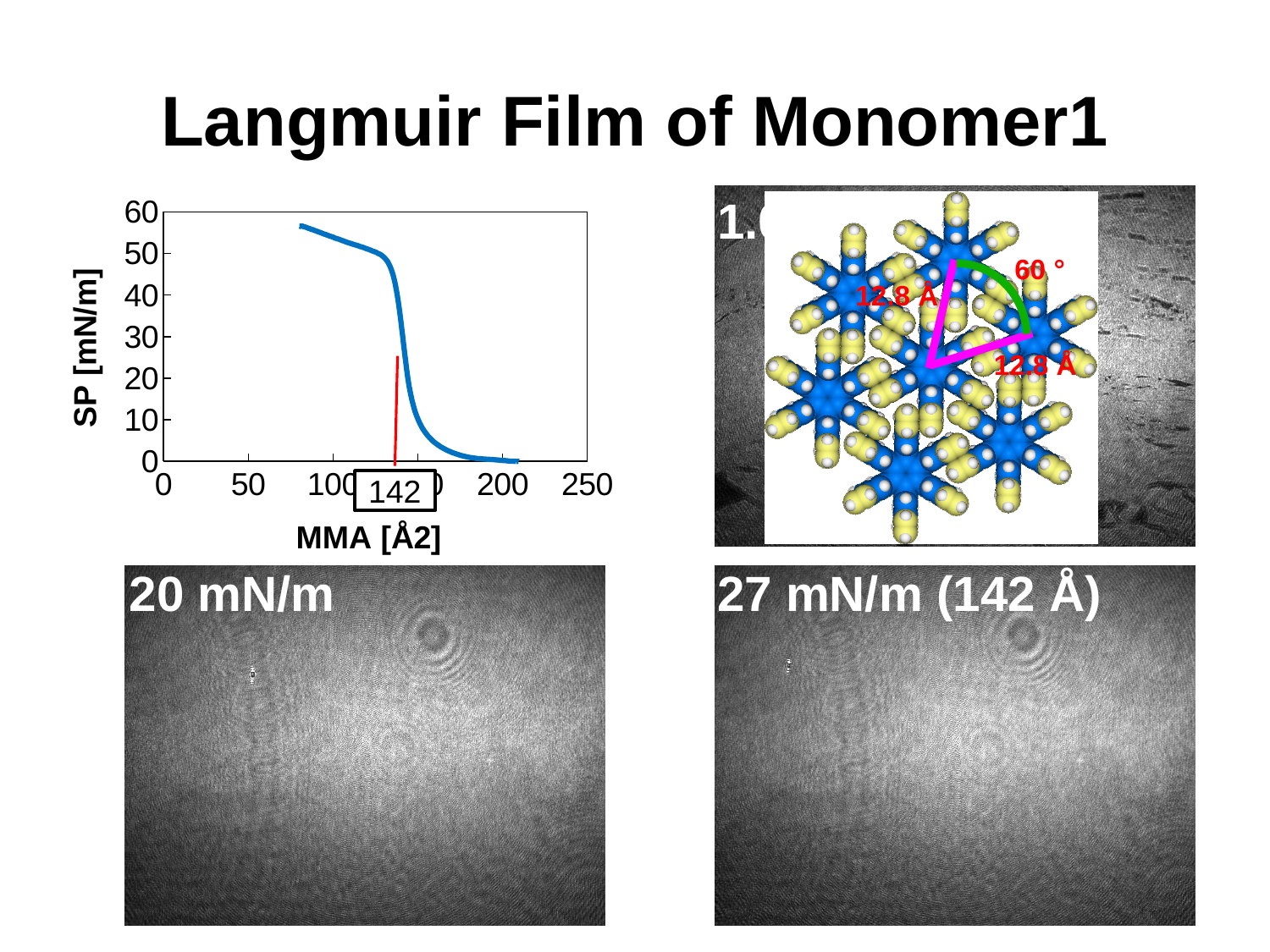
How many data series are plotted in the chart? 1 What is the label of the y axis of the chart? SP [mN/m] What kind of chart is shown on the left of the slide? line chart Is the SP value at MMA 100 greater or less than 40? greater What is the highest tick value shown on the y axis of the chart? 60 What MMA value is marked by the red vertical line and boxed label on the chart? 142 Is the SP value at MMA 200 greater or less than 10? less What is the highest tick value shown on the x axis of the chart? 250 What is the label of the x axis of the chart? MMA [Å2] In the chart, does SP rise or fall as MMA increases along the x axis? fall Which is larger, the SP value at MMA 100 or the SP value at MMA 200? MMA 100 Is the SP value at MMA 150 greater or less than 30? less